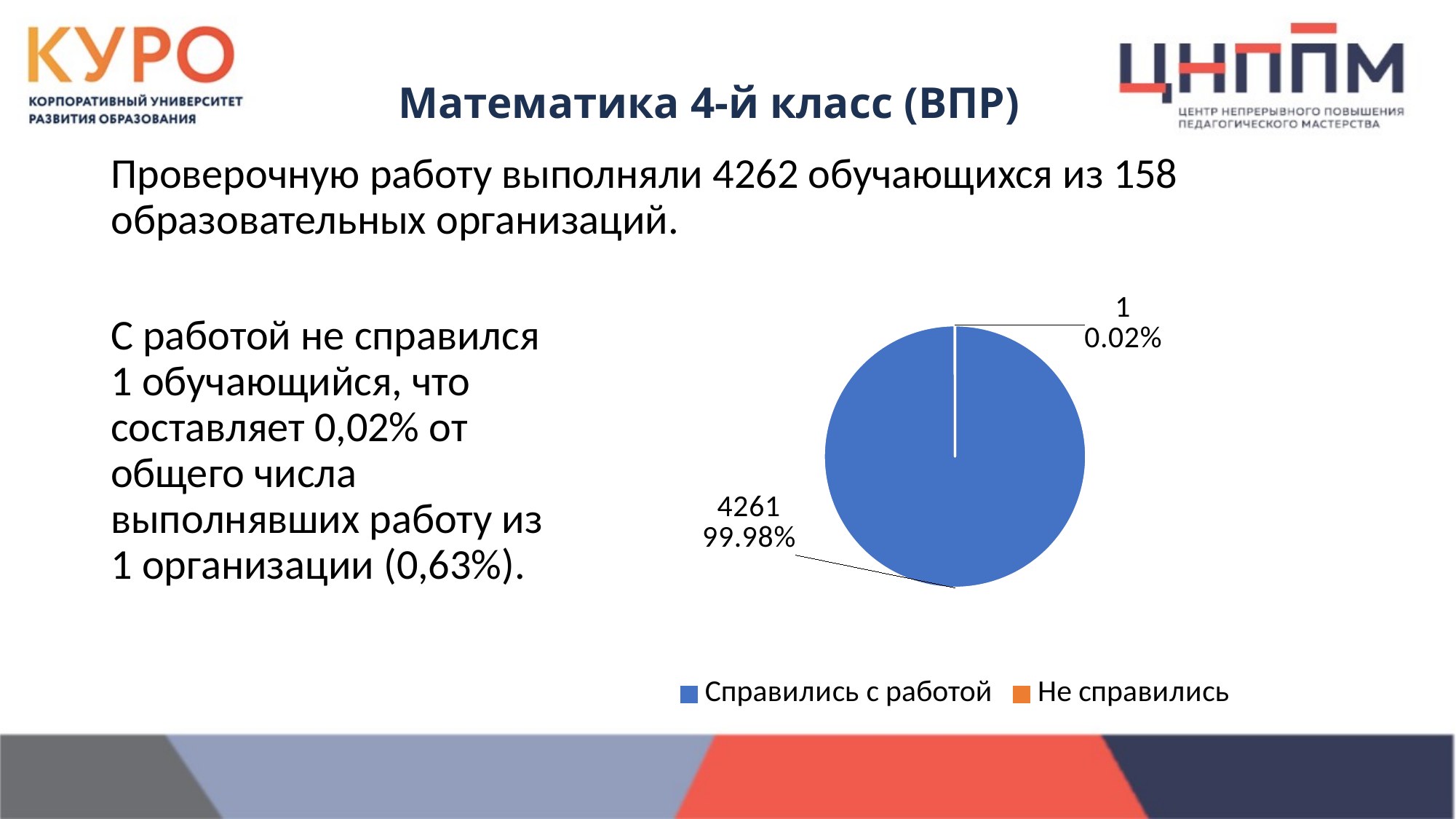
How many entries does the legend of the pie chart list? 2 How many students are in the 'Не справились' slice of the pie chart? 1 Which slice of the pie chart is the largest? Справились с работой Which slice of the pie chart is the smallest? Не справились What share of the pie does the 'Не справились' slice represent? 0.02% How many slices does the pie chart have? 2 Which is larger: the 'Справились с работой' slice or the 'Не справились' slice? Справились с работой How many students are in the 'Справились с работой' slice of the pie chart? 4261 What colour is the 'Справились с работой' slice in the pie chart? blue What share of the pie does the 'Справились с работой' slice represent? 99.98% What is the difference between the number of students who passed and the number who did not pass? 4260 What kind of chart is shown on the slide? pie chart